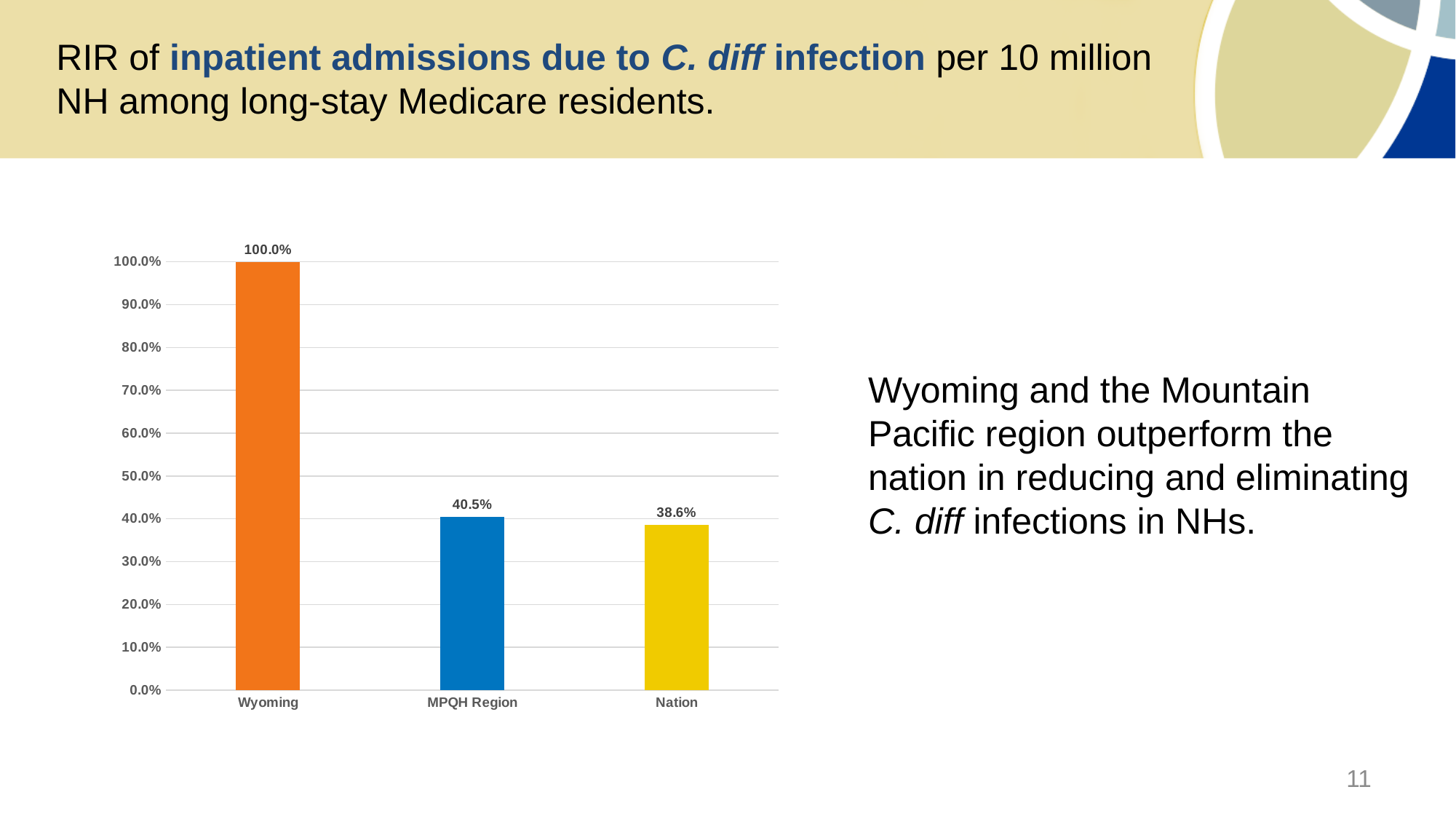
What is the value for Wyoming? 100.0% What is the difference between the values for MPQH Region and Nation? 1.9% Which category has the highest value? Wyoming What is the value for MPQH Region? 40.5% Which is larger, the value for Wyoming or the value for Nation? Wyoming What kind of chart is shown on the slide? bar chart How many categories are shown on the x axis? 3 What is the difference between the values for Wyoming and MPQH Region? 59.5% Is the value for MPQH Region greater or less than 50.0%? less What colour is the bar for Wyoming? orange What is the value for Nation? 38.6% Which category has the lowest value? Nation